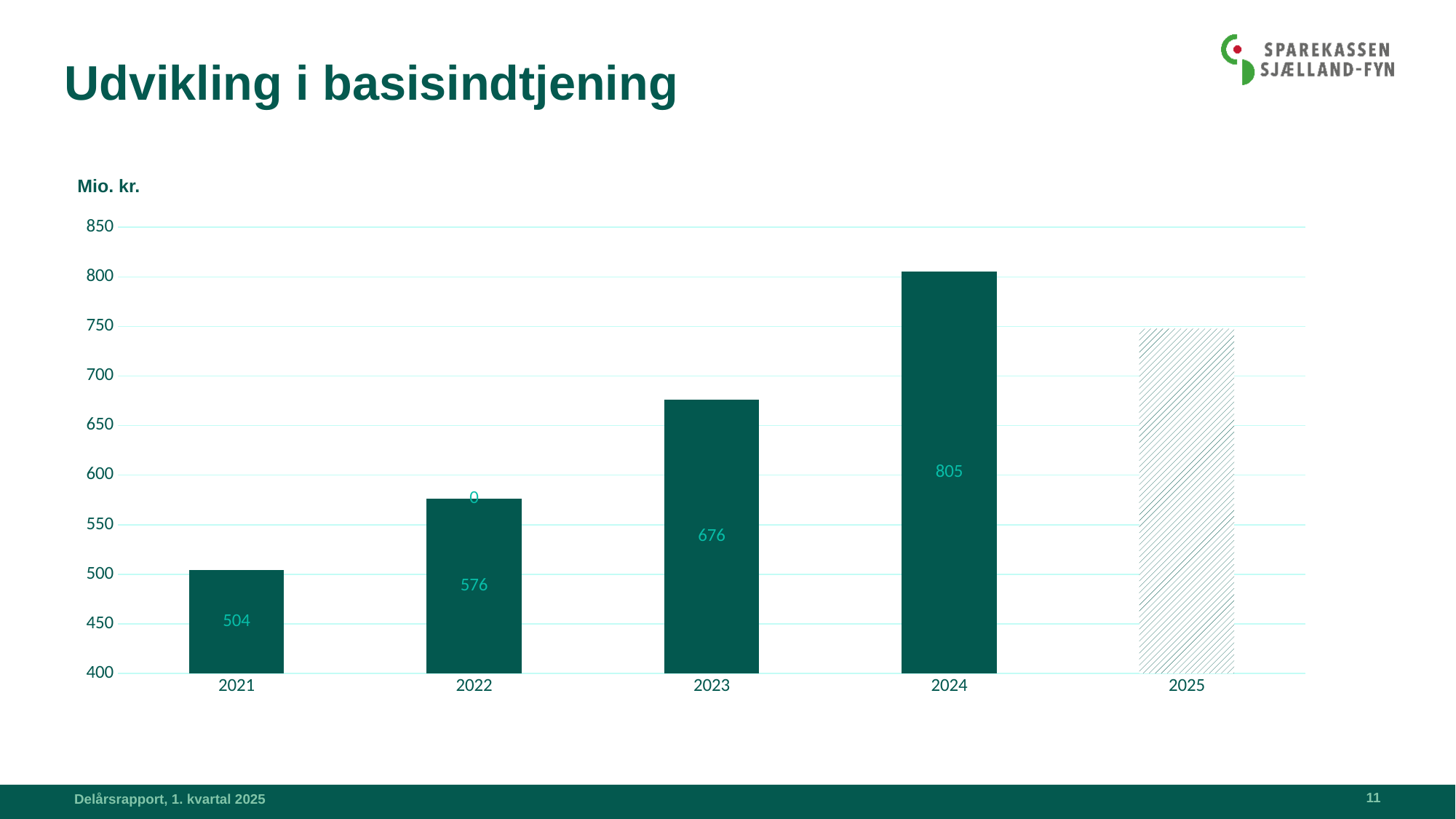
Which is larger, the value for 2022 or the value for 2023? 2023 What is the value for 2022? 576 Which year has the highest value? 2024 What is the difference between the values for 2024 and 2021? 301 What is the value for 2023? 676 How many years are shown on the x axis? 5 Is the value for 2025 greater or less than 700? greater What is the value for 2024? 805 What kind of chart is shown on the slide? bar chart What is the value for 2021? 504 Which year has the lowest value? 2021 Do the values rise or fall from 2021 to 2024? rise